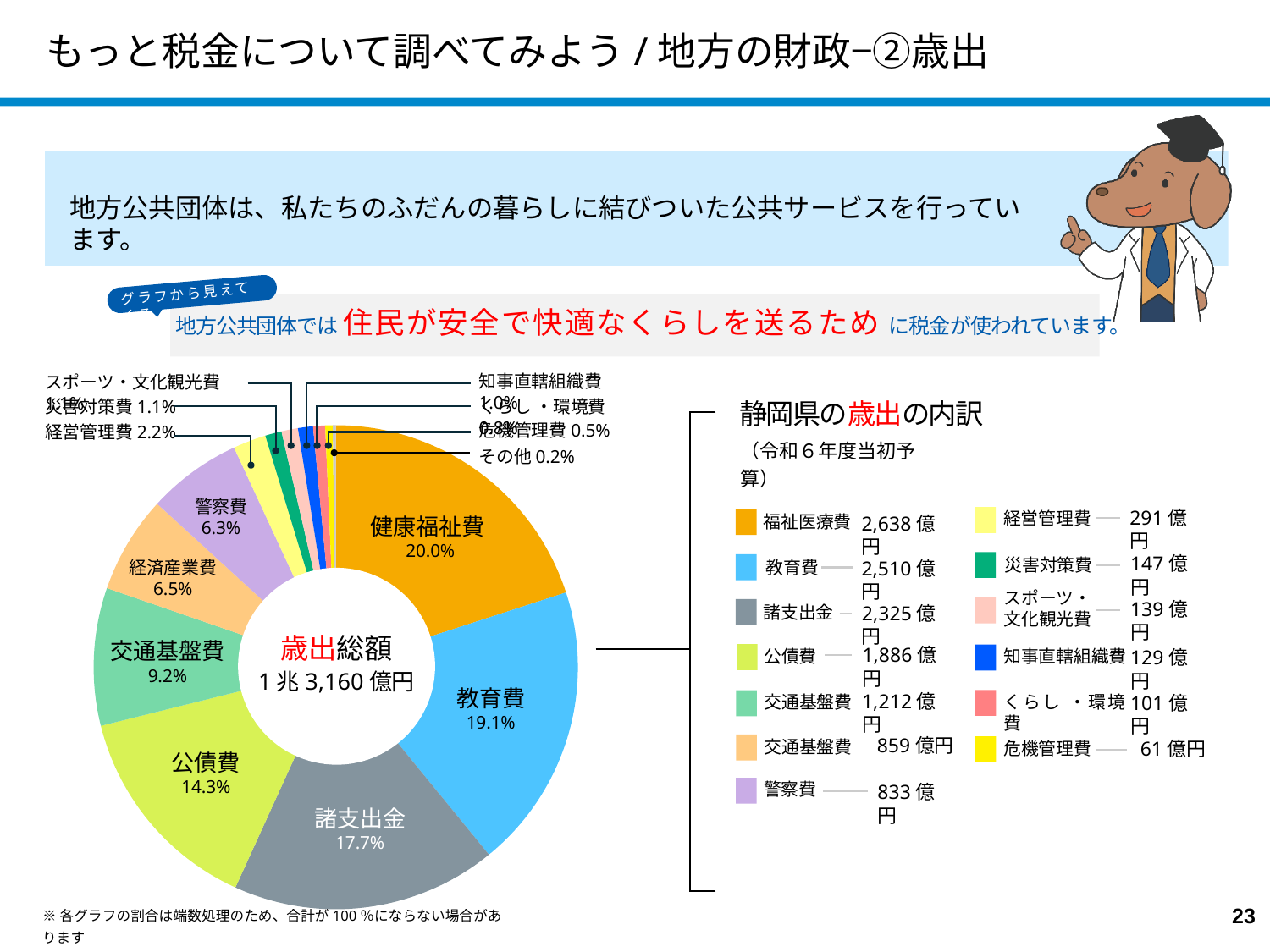
What percentage of the expenditure does 教育費 account for? 19.1% What percentage of the expenditure does 健康福祉費 account for? 20.0% What percentage is shown for 諸支出金? 17.7% Which has a larger share, 交通基盤費 or 警察費? 交通基盤費 What kind of chart is shown on the slide? Pie (donut) chart What is the title of the chart on the right side of the slide? 静岡県の歳出の内訳 What is the difference in percentage points between 健康福祉費 and 教育費? 0.9 Which category has the smallest share of the expenditure? その他 What percentage is shown for 公債費? 14.3% Which category has the largest share of the expenditure? 健康福祉費 According to the legend, what is the amount for 公債費? 1,886億円 What is the total expenditure (歳出総額) shown in the centre of the chart? 1兆3,160億円